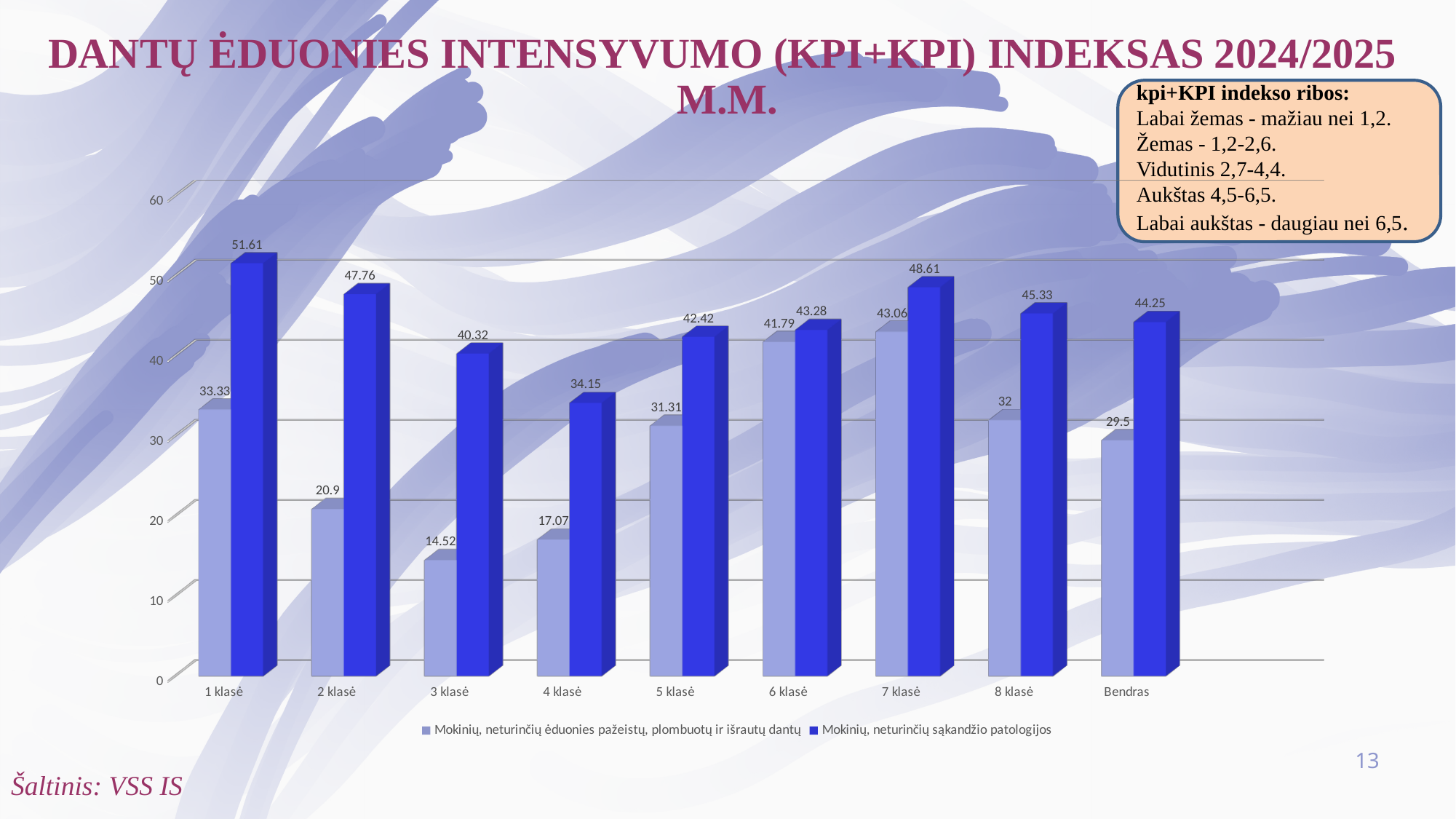
How many series does the legend list? 2 Which is larger for 6 klasė: the value for 'Mokinių, neturinčių ėduonies pažeistų, plombuotų ir išrautų dantų' or for 'Mokinių, neturinčių sąkandžio patologijos'? Mokinių, neturinčių sąkandžio patologijos How many categories are shown on the x axis? 9 What is the difference between the two series' values for 2 klasė? 26.86 What is the value for 4 klasė in the series 'Mokinių, neturinčių sąkandžio patologijos'? 34.15 What kind of chart is shown on the slide? bar chart What is the value for Bendras in the series 'Mokinių, neturinčių sąkandžio patologijos'? 44.25 Which category has the highest value in the series 'Mokinių, neturinčių ėduonies pažeistų, plombuotų ir išrautų dantų'? 7 klasė Is the value for 8 klasė in the series 'Mokinių, neturinčių sąkandžio patologijos' greater or less than 40? greater What is the value for 3 klasė in the series 'Mokinių, neturinčių ėduonies pažeistų, plombuotų ir išrautų dantų'? 14.52 Which category has the lowest value in the series 'Mokinių, neturinčių sąkandžio patologijos'? 4 klasė What is the value for 1 klasė in the series 'Mokinių, neturinčių sąkandžio patologijos'? 51.61